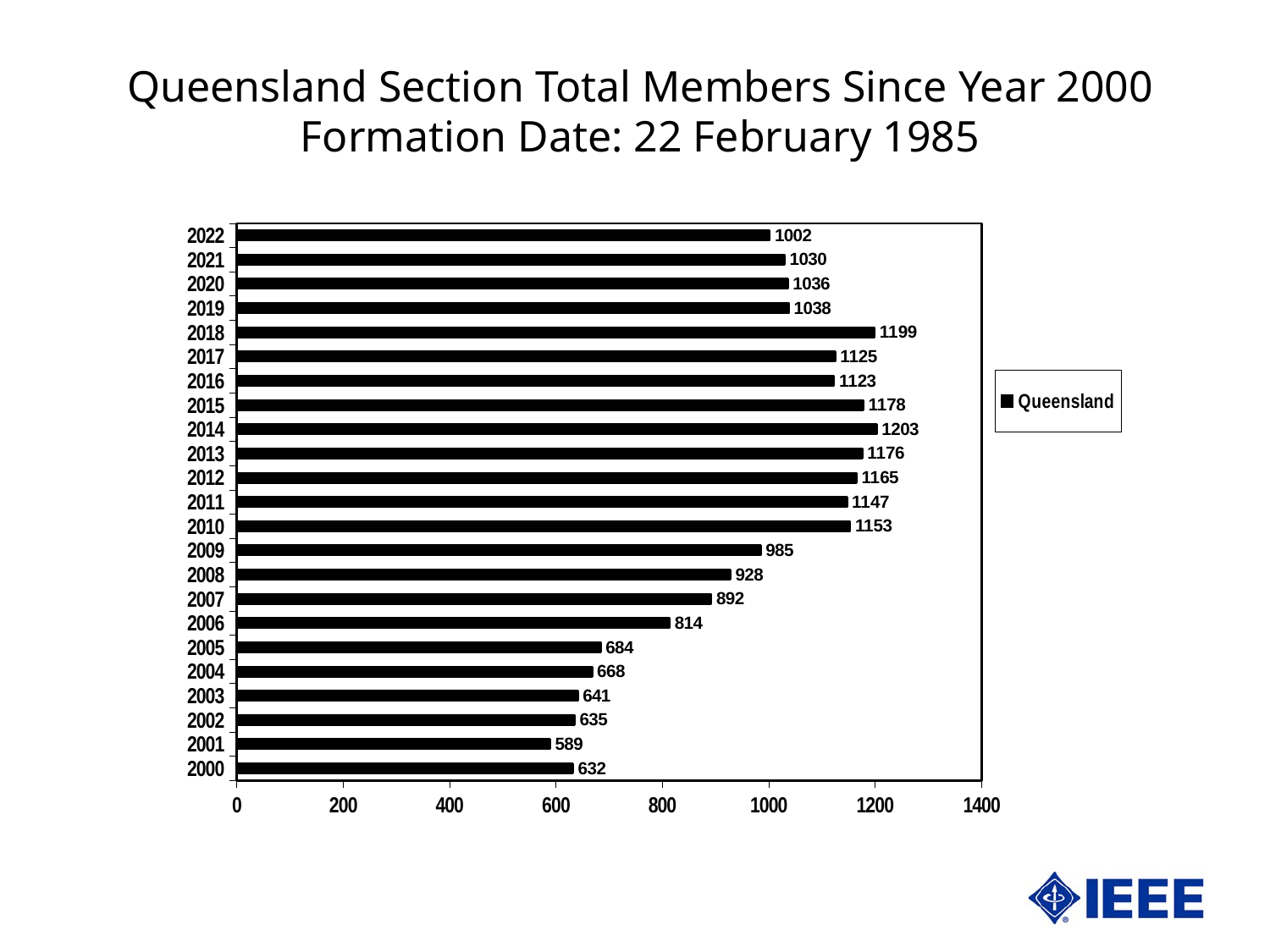
How many years are shown on the chart? 23 Which year has the highest value? 2014 What series name appears in the legend? Queensland How many series does the legend list? 1 What is the value for 2018? 1199 What is the value for 2001? 589 Which year has the lowest value? 2001 Is the value for 2006 greater or less than 800? greater What is the value for 2022? 1002 What kind of chart is shown? bar chart What is the difference between the values for 2014 and 2000? 571 Which is larger, the value for 2009 or the value for 2008? 2009